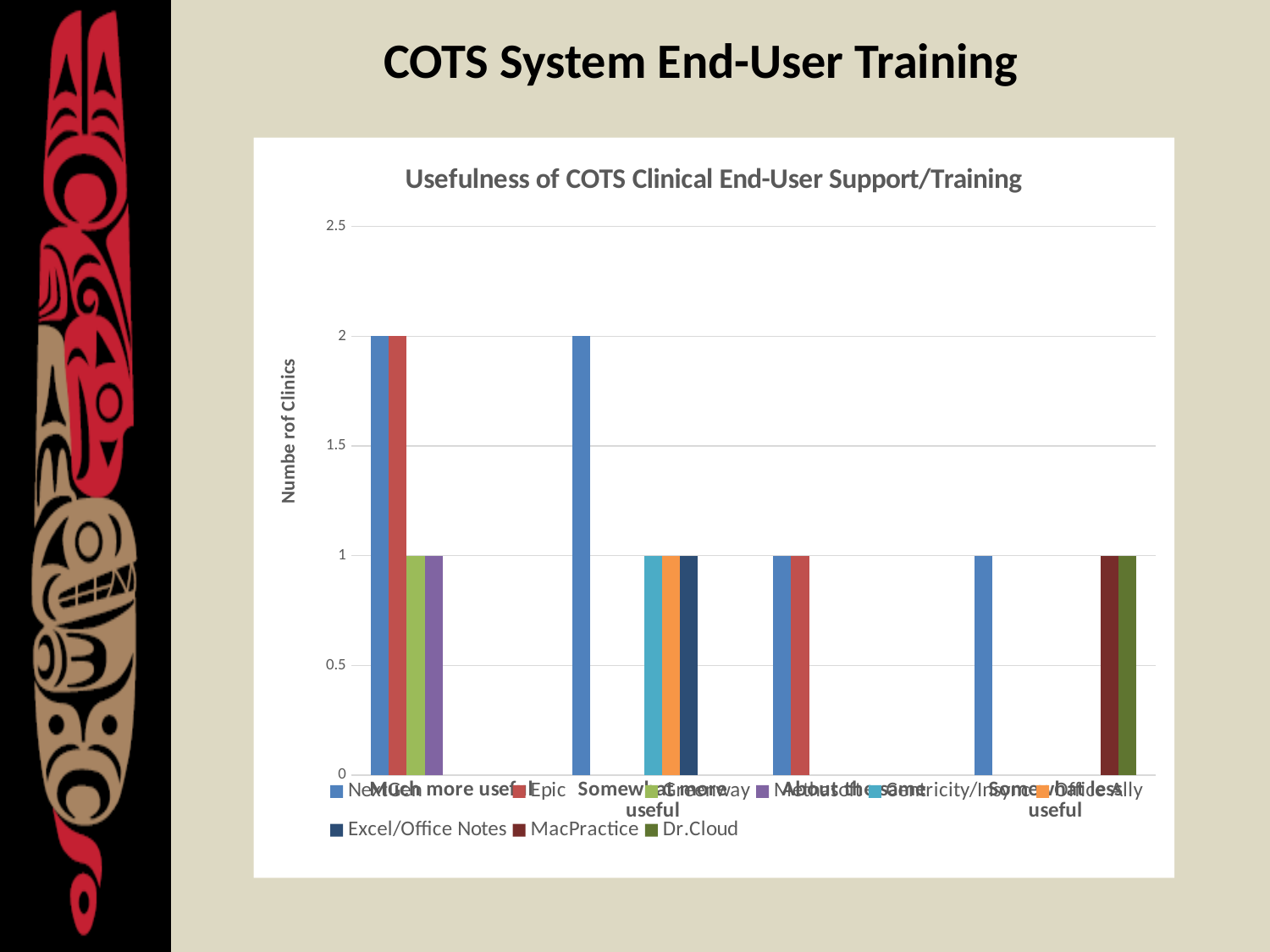
What is the value for MacPractice in the 'Somewhat less useful' category? 1 What is the title of the chart? Usefulness of COTS Clinical End-User Support/Training How many series does the chart legend list? 9 What kind of chart is shown on the slide? Bar chart What is the value for Dr.Cloud in the 'Somewhat less useful' category? 1 Which is larger: Epic in 'Much more useful' or Epic in 'About the same'? Epic in 'Much more useful' What is the highest value reached by any bar in the chart? 2 What is the difference between Epic's value in 'Much more useful' and its value in 'About the same'? 1 What is the value for Epic in the 'Much more useful' category? 2 What is the value for Excel/Office Notes in the 'Somewhat more useful' category? 1 How many categories are shown along the x axis? 4 What is the value for Epic in the 'About the same' category? 1